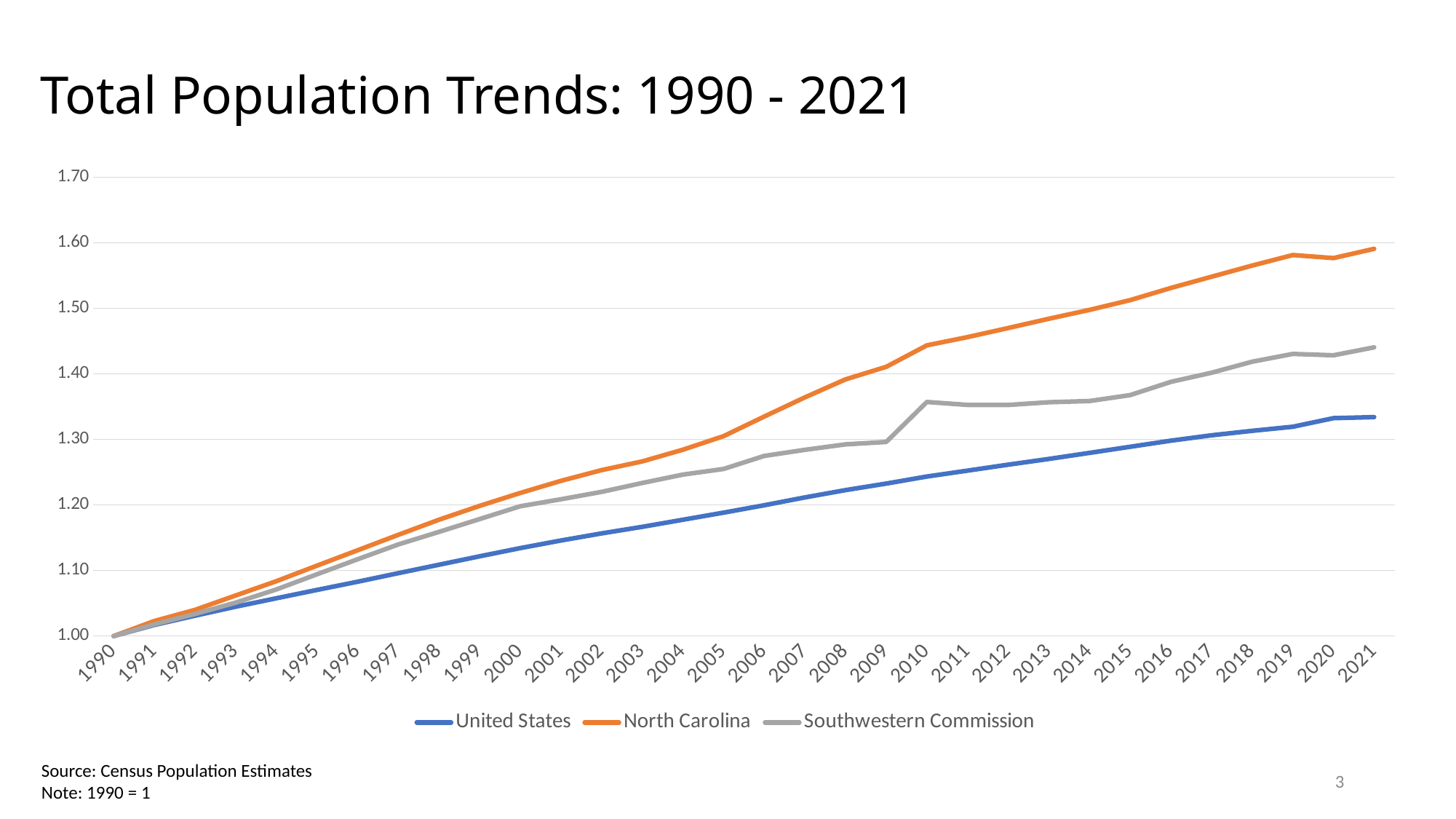
Which series has the highest value in 2021? North Carolina How many series does the legend list? 3 Does the United States line rise or fall from 1990 to 2021? Rise Is the value for United States in 2021 greater or less than 1.40? less How many years are plotted along the x axis? 32 Is the value for Southwestern Commission in 2010 greater or less than 1.30? greater What kind of chart is shown on the slide? Line chart Which series has the lowest value in 2021? United States What is the title of the slide? Total Population Trends: 1990 - 2021 Is the value for North Carolina in 2021 greater or less than 1.50? greater What is the value for United States in 1990? 1.00 In 2015, which is larger: North Carolina or Southwestern Commission? North Carolina